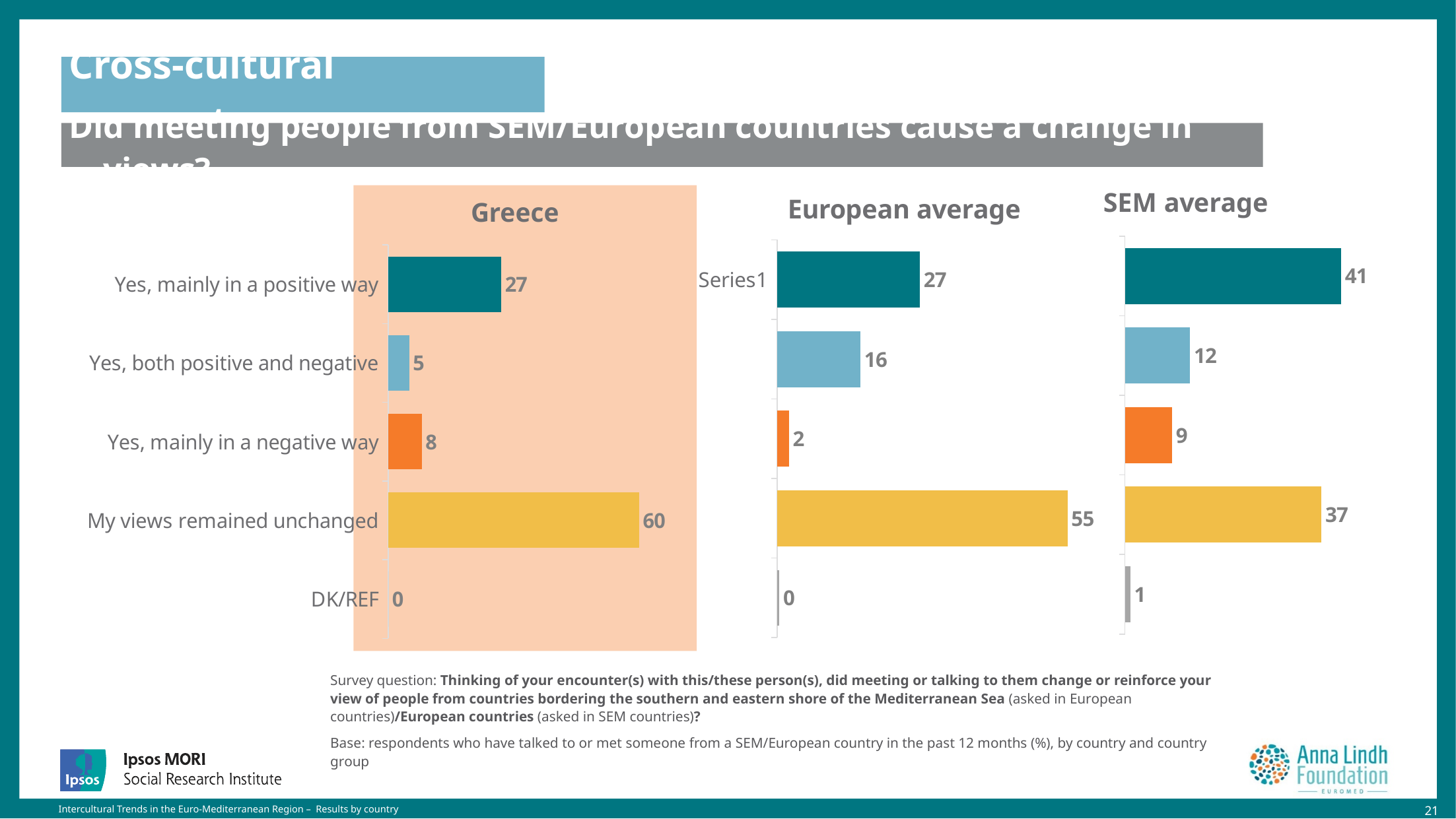
In the SEM average chart, what is the difference between "Yes, mainly in a positive way" and "My views remained unchanged"? 4 In the SEM average chart, which category has the lowest value? DK/REF What kind of chart is the European average chart? bar chart How many categories are shown in the Greece chart? 5 In the European average chart, what is the value for "Yes, both positive and negative"? 16 What is the title of the chart on the right of the slide? SEM average Is the value for "Yes, mainly in a negative way" larger in the Greece chart or in the SEM average chart? SEM average In the European average chart, what is the difference between "My views remained unchanged" and "Yes, mainly in a positive way"? 28 In the SEM average chart, what is the value for "Yes, mainly in a positive way"? 41 In the Greece chart, what is the value for "My views remained unchanged"? 60 In the Greece chart, what is the value for DK/REF? 0 In the Greece chart, which category has the highest value? My views remained unchanged